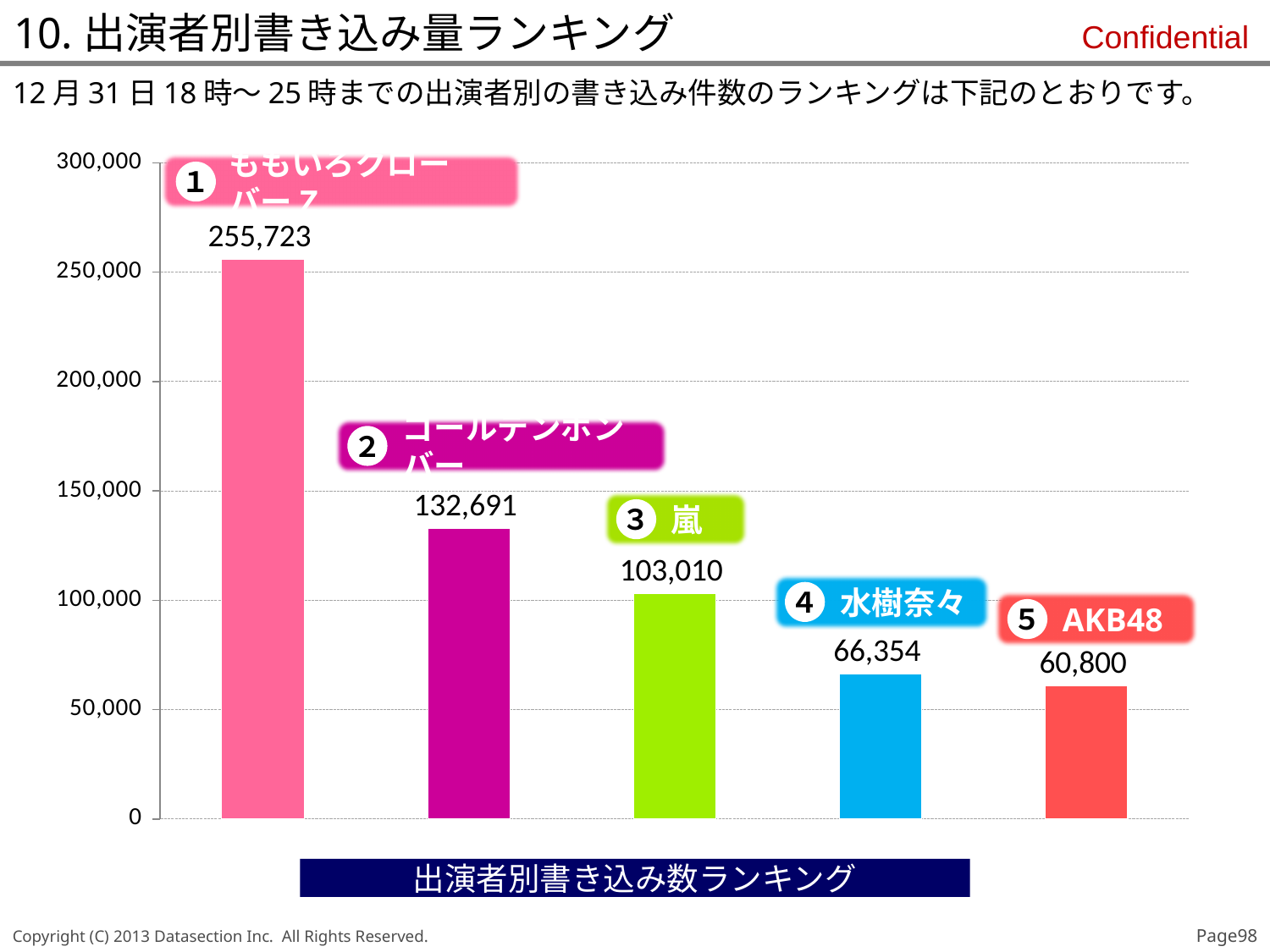
Do the values rise or fall from left to right across the bars? fall What kind of chart is shown on the slide? bar chart What is the value for AKB48 (rank 5)? 60,800 What is the value of the rank 2 bar? 132,691 What is the value for 嵐 (rank 3)? 103,010 Which performer has the lowest number of posts? AKB48 What is the value of the rank 1 bar? 255,723 What is the value for 水樹奈々 (rank 4)? 66,354 How many bars are shown in the chart? 5 What is the difference between the rank 1 bar and the rank 2 bar? 123,032 What is the difference between the values for 嵐 and AKB48? 42,210 Which is larger, the value for 水樹奈々 or the value for AKB48? 水樹奈々